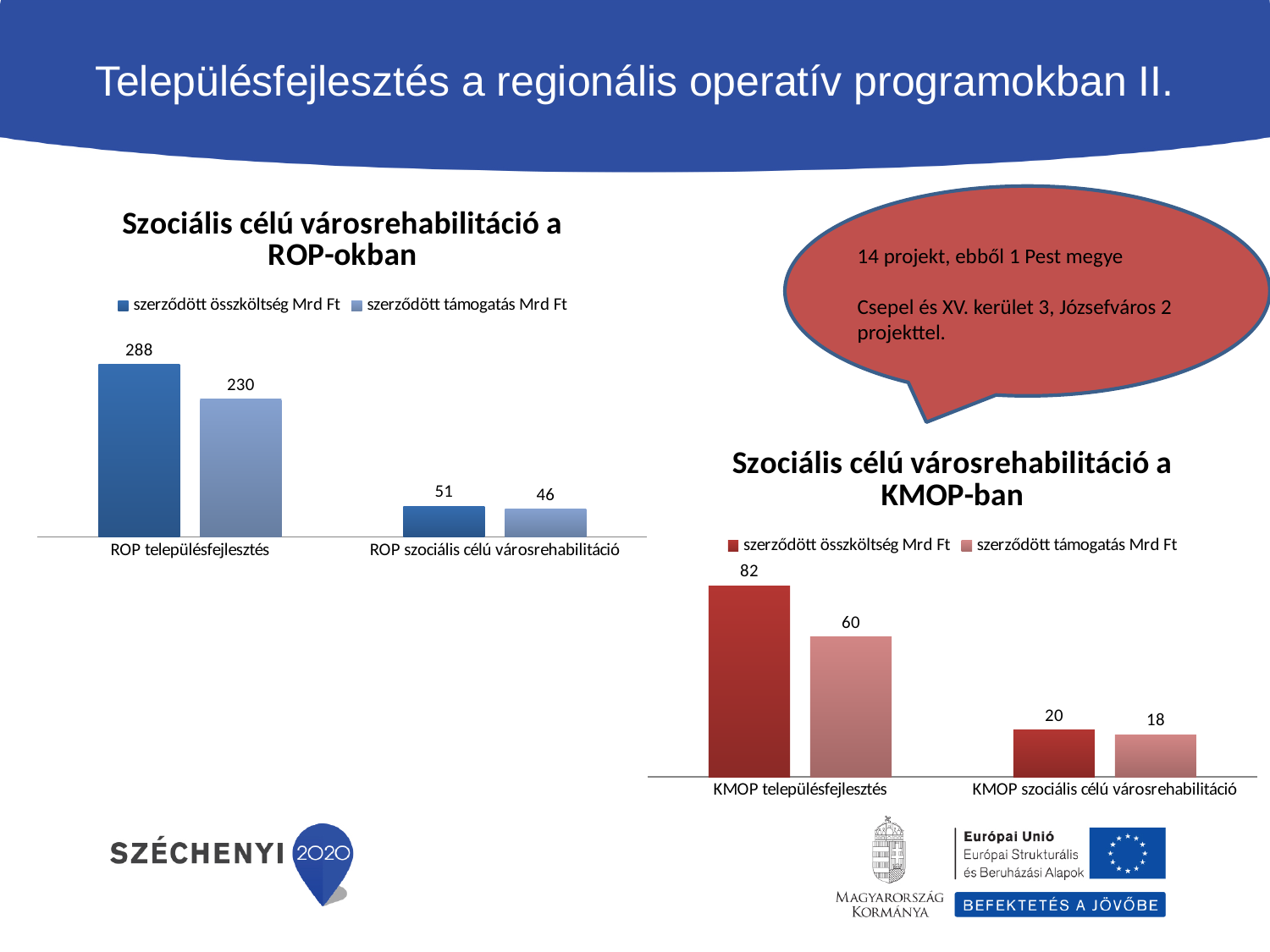
In the chart 'Szociális célú városrehabilitáció a KMOP-ban', how many categories are shown on the x axis? 2 In the chart 'Szociális célú városrehabilitáció a ROP-okban', what is the difference between 'szerződött összköltség Mrd Ft' and 'szerződött támogatás Mrd Ft' for 'ROP településfejlesztés'? 58 In the chart 'Szociális célú városrehabilitáció a ROP-okban', how many series does the legend list? 2 In the chart 'Szociális célú városrehabilitáció a KMOP-ban', which category has the lowest 'szerződött támogatás Mrd Ft'? KMOP szociális célú városrehabilitáció In the chart 'Szociális célú városrehabilitáció a KMOP-ban', what is the value of 'szerződött támogatás Mrd Ft' for 'KMOP szociális célú városrehabilitáció'? 18 In the chart 'Szociális célú városrehabilitáció a KMOP-ban', what is the value of 'szerződött összköltség Mrd Ft' for 'KMOP településfejlesztés'? 82 In the chart 'Szociális célú városrehabilitáció a ROP-okban', what is the value of 'szerződött összköltség Mrd Ft' for 'ROP településfejlesztés'? 288 In the chart 'Szociális célú városrehabilitáció a KMOP-ban', what is the difference between 'szerződött összköltség Mrd Ft' and 'szerződött támogatás Mrd Ft' for 'KMOP településfejlesztés'? 22 What kind of chart is 'Szociális célú városrehabilitáció a KMOP-ban'? Bar chart In the chart 'Szociális célú városrehabilitáció a ROP-okban', which category has the highest 'szerződött összköltség Mrd Ft'? ROP településfejlesztés In the chart 'Szociális célú városrehabilitáció a ROP-okban', which is larger: 'szerződött támogatás Mrd Ft' for 'ROP településfejlesztés' or 'szerződött összköltség Mrd Ft' for 'ROP szociális célú városrehabilitáció'? szerződött támogatás Mrd Ft for ROP településfejlesztés In the chart 'Szociális célú városrehabilitáció a ROP-okban', what is the value of 'szerződött támogatás Mrd Ft' for 'ROP szociális célú városrehabilitáció'? 46